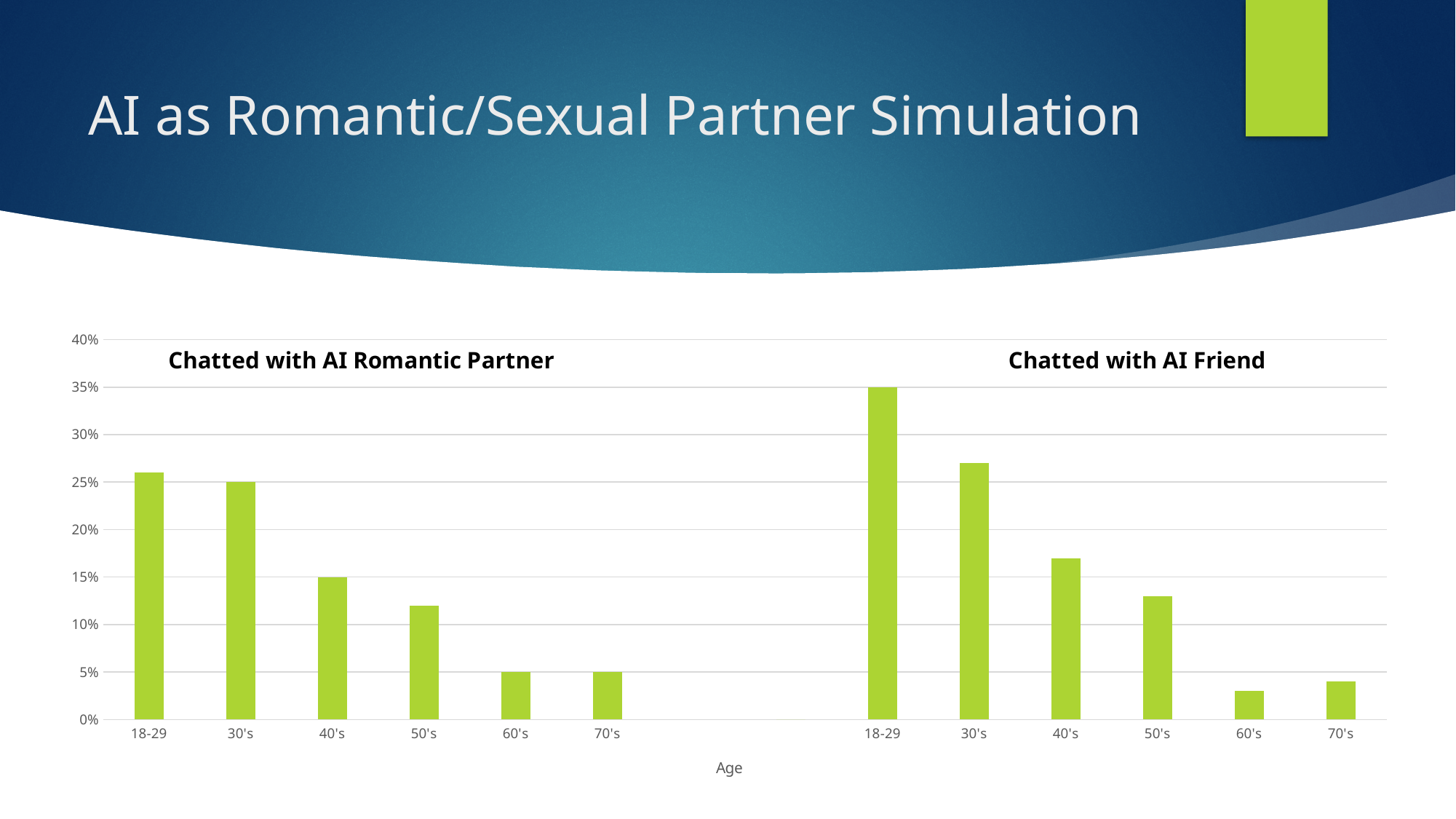
Is the value for the 60's age group in the "Chatted with AI Friend" section greater or less than 5%? less Is the value for the 30's age group in the "Chatted with AI Friend" section greater or less than 25%? greater Which is larger: the 18-29 value for "Chatted with AI Friend" or the 18-29 value for "Chatted with AI Romantic Partner"? Chatted with AI Friend In the "Chatted with AI Friend" section, do the values generally rise or fall as age increases? fall What kind of chart is shown on the slide? bar chart What is the label on the horizontal axis of the chart? Age How many age groups are shown in the "Chatted with AI Romantic Partner" section? 6 In the "Chatted with AI Romantic Partner" section, what is the value for the 40's age group? 15% In the "Chatted with AI Friend" section, which age group has the highest value? 18-29 In the "Chatted with AI Friend" section, what is the value for the 18-29 age group? 35% Is the value for the 50's age group in the "Chatted with AI Romantic Partner" section greater or less than 15%? less In the "Chatted with AI Romantic Partner" section, what is the value for the 60's age group? 5%